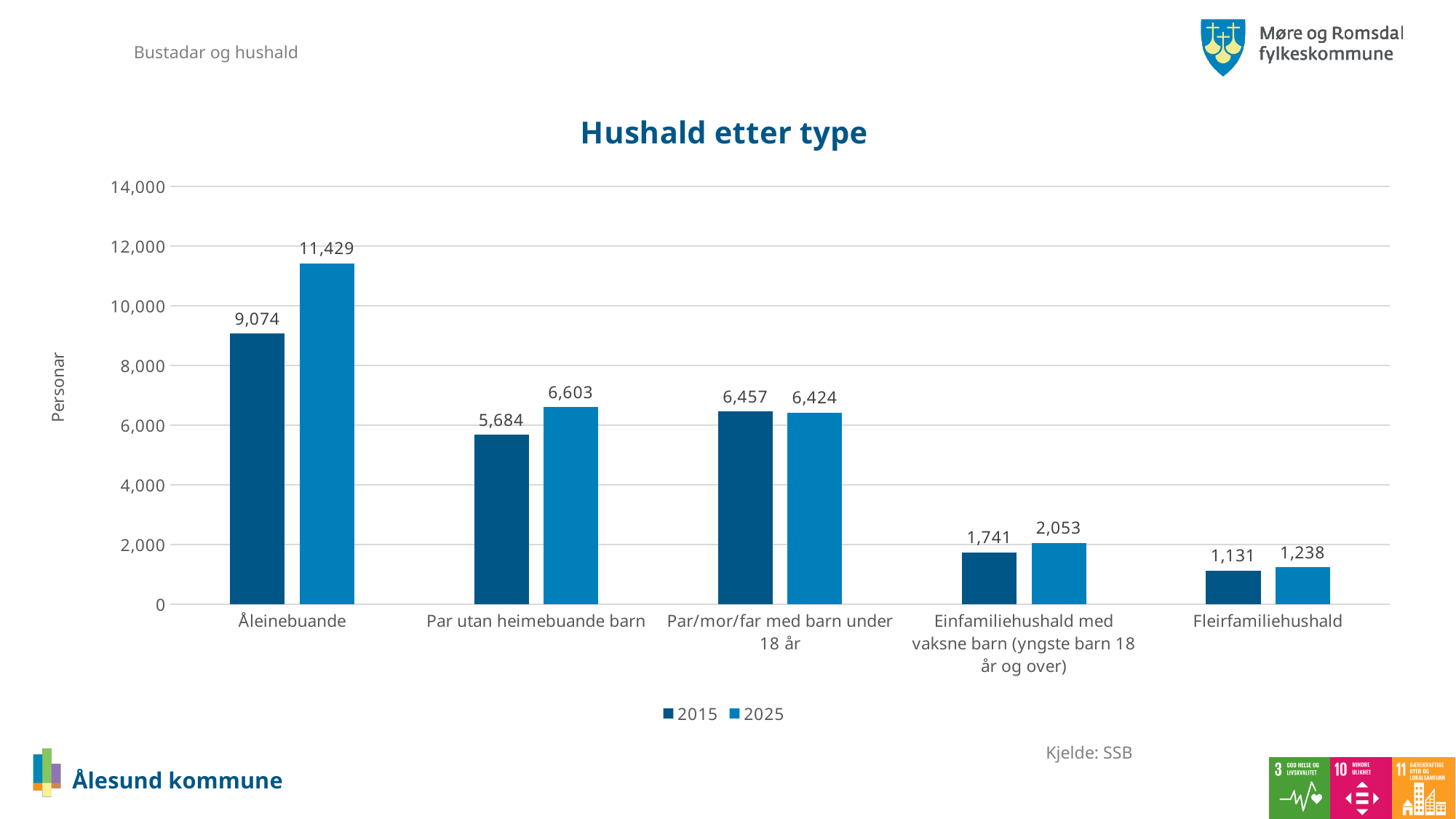
What kind of chart is shown? bar chart What is the value for Åleinebuande in 2025? 11,429 What is the value for Par utan heimebuande barn in 2015? 5,684 Which category has the highest value in 2015? Åleinebuande Which category has the lowest value in 2025? Fleirfamiliehushald What is the difference between the 2025 and 2015 values for Åleinebuande? 2,355 Is the 2015 value for Einfamiliehushald med vaksne barn greater or less than 2,000? less How many series does the legend list? 2 What is the title of the chart? Hushald etter type What is the value for Fleirfamiliehushald in 2025? 1,238 Which is larger for Par/mor/far med barn under 18 år: the 2015 value or the 2025 value? 2015 How many household type categories are shown on the x axis? 5